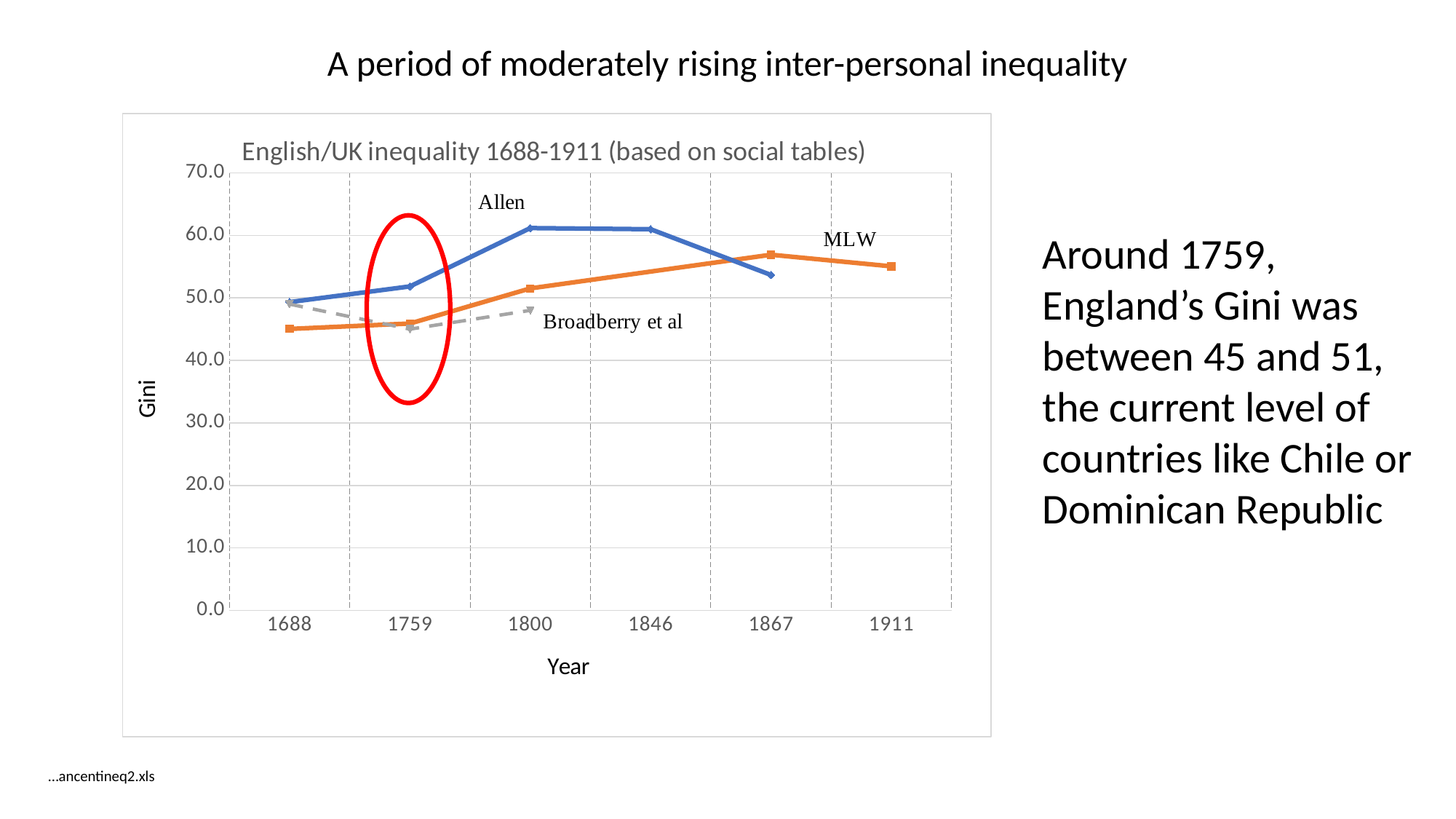
What is the label of the y axis? Gini Is the Broadberry et al value for 1759 greater or less than 50? less How many years are marked on the x axis of the chart? 6 What is the title of the chart? English/UK inequality 1688-1911 (based on social tables) Does the MLW series rise or fall from 1688 to 1867? rise Is the MLW value for 1688 greater or less than 50? less In which year does the MLW series reach its highest value? 1867 How many series are labelled on the chart? 3 What kind of chart is shown on the slide? line chart Which series has the larger value in 1800, Allen or MLW? Allen Is the Allen value for 1800 greater or less than 50? greater In which year does the Allen series have its lowest value? 1688